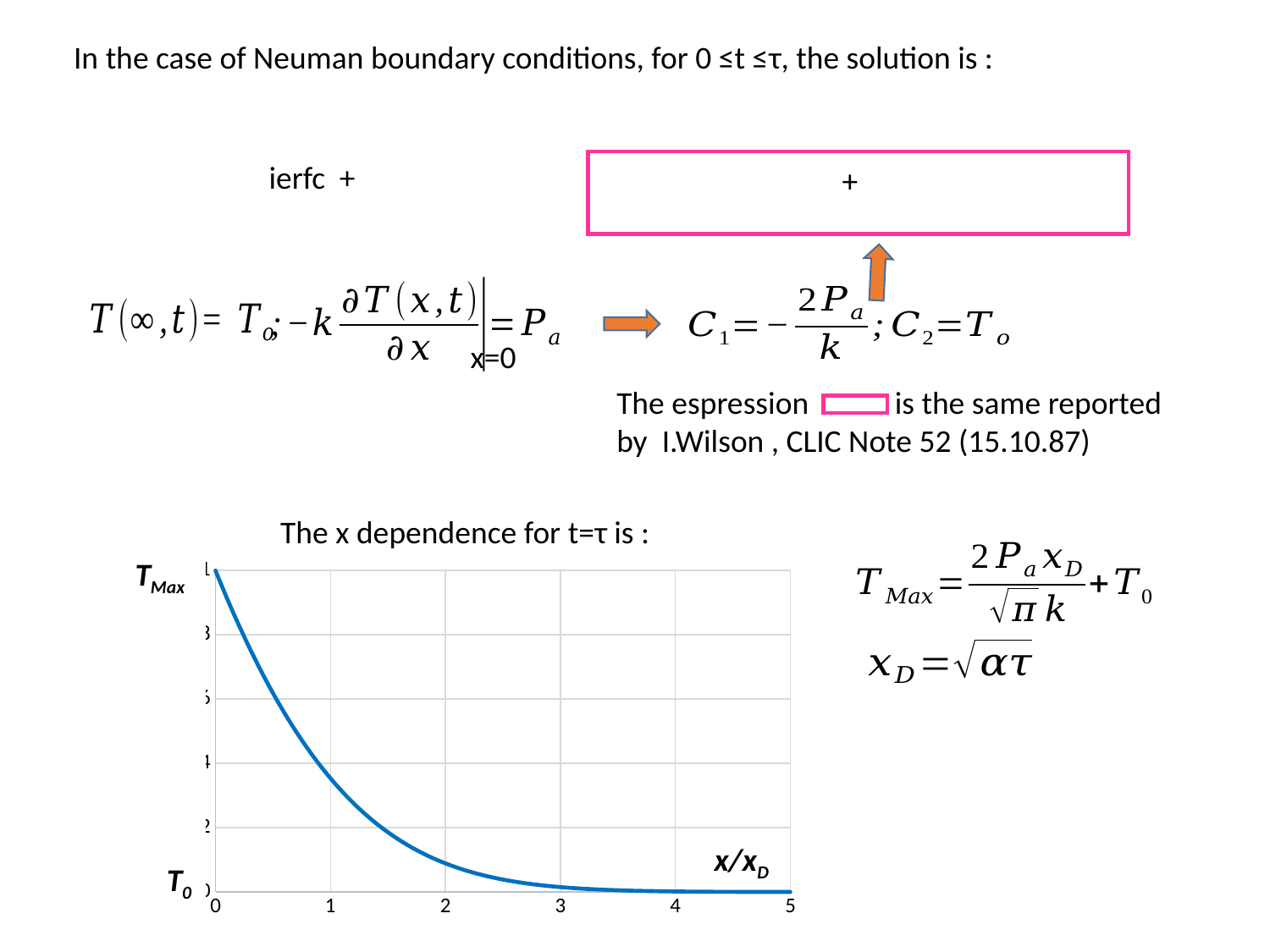
What is the largest x/x_D value shown on the x axis? 5 Toward which labelled level does the curve approach at x/x_D = 5? T_0 Which is larger, the curve value at x/x_D = 0 or at x/x_D = 2? x/x_D = 0 Does the plotted curve rise or fall as x/x_D increases from 0 to 5? fall What is the label on the x axis of the chart? x/x_D Which is larger, the curve value at x/x_D = 1 or at x/x_D = 3? x/x_D = 1 At which value of x/x_D does the curve reach its highest point? 0 How many tick labels are shown on the x axis of the chart? 6 What label marks the top of the y axis, where the curve starts? T_Max What kind of chart is shown on the slide? line chart